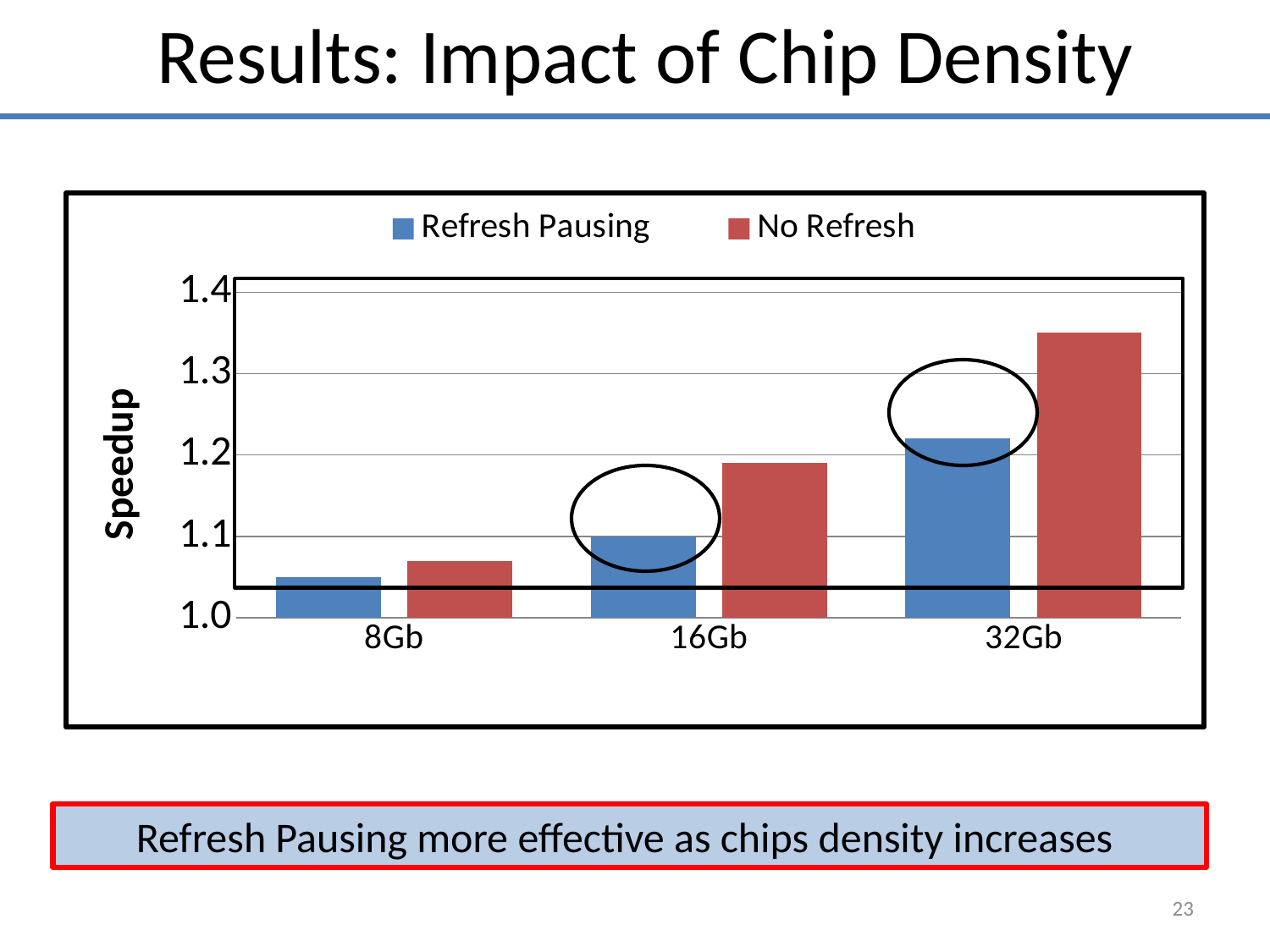
At 32Gb, which is larger: the Refresh Pausing speedup or the No Refresh speedup? No Refresh Is the Refresh Pausing speedup at 32Gb greater or less than 1.2? greater For which chip density is the No Refresh speedup highest? 32Gb What is the label of the y axis? Speedup Is the No Refresh speedup at 8Gb greater or less than 1.1? less Do the Refresh Pausing speedup values rise or fall as chip density increases from 8Gb to 32Gb? rise Is the No Refresh speedup at 32Gb greater or less than 1.3? greater How many series does the chart's legend list? 2 Which series is shown in red in the legend? No Refresh What kind of chart is shown on the slide? bar chart How many chip density categories are shown on the x axis? 3 For which chip density is the Refresh Pausing speedup lowest? 8Gb